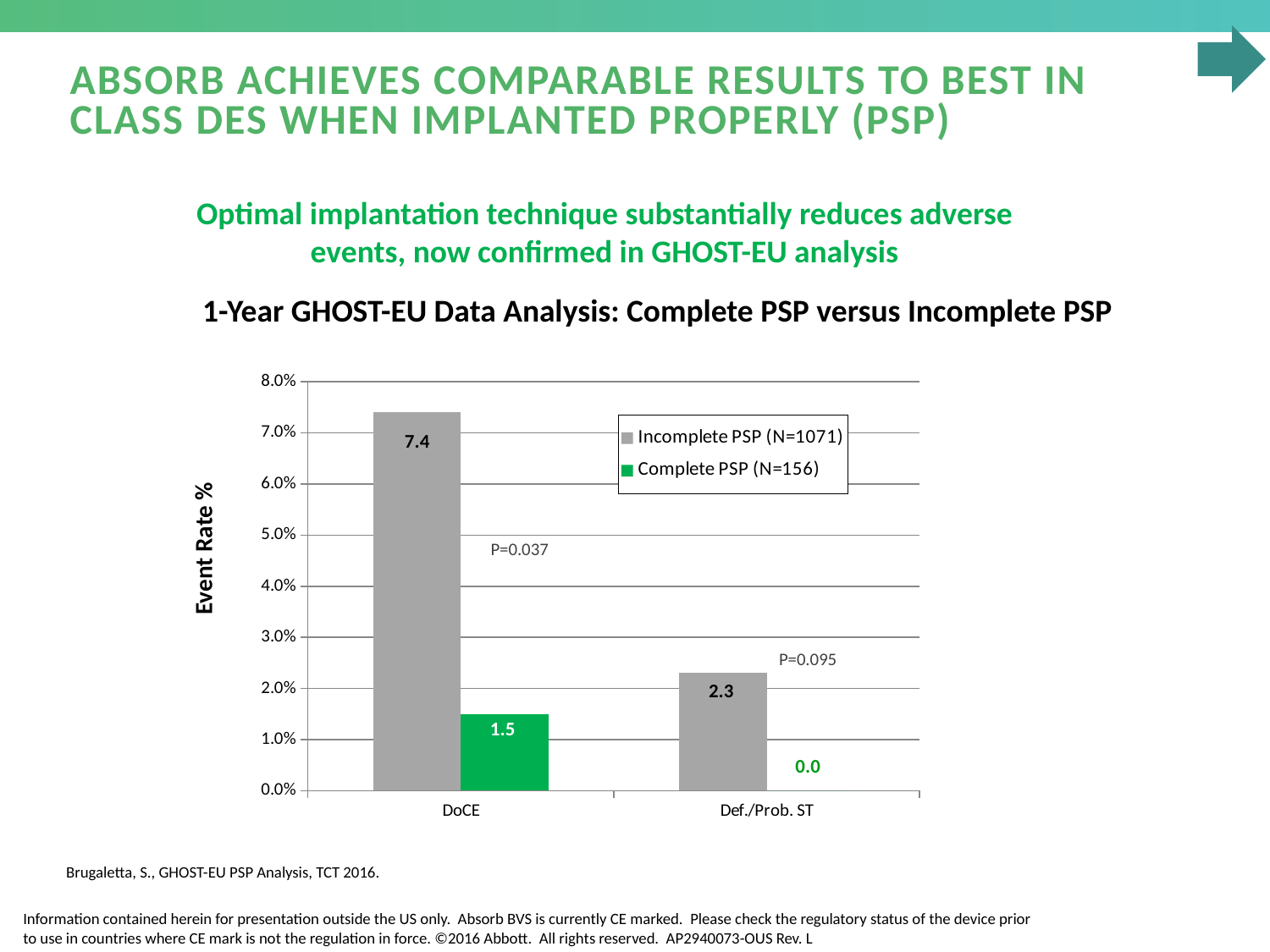
What is the event rate for Complete PSP in the Def./Prob. ST category? 0.0 Is the Incomplete PSP event rate for DoCE greater or less than 7.0%? greater What is the event rate for Incomplete PSP in the Def./Prob. ST category? 2.3 How many series does the legend list? 2 What is the event rate for Complete PSP in the DoCE category? 1.5 What is the difference between the Incomplete PSP and Complete PSP event rates for DoCE? 5.9 What is the event rate for Incomplete PSP in the DoCE category? 7.4 Which category has the highest Incomplete PSP event rate? DoCE What type of chart is shown on the slide? Bar chart Which is larger, the Incomplete PSP event rate for DoCE or for Def./Prob. ST? DoCE How many categories are shown on the x axis? 2 What is the difference between the Incomplete PSP event rates for DoCE and Def./Prob. ST? 5.1